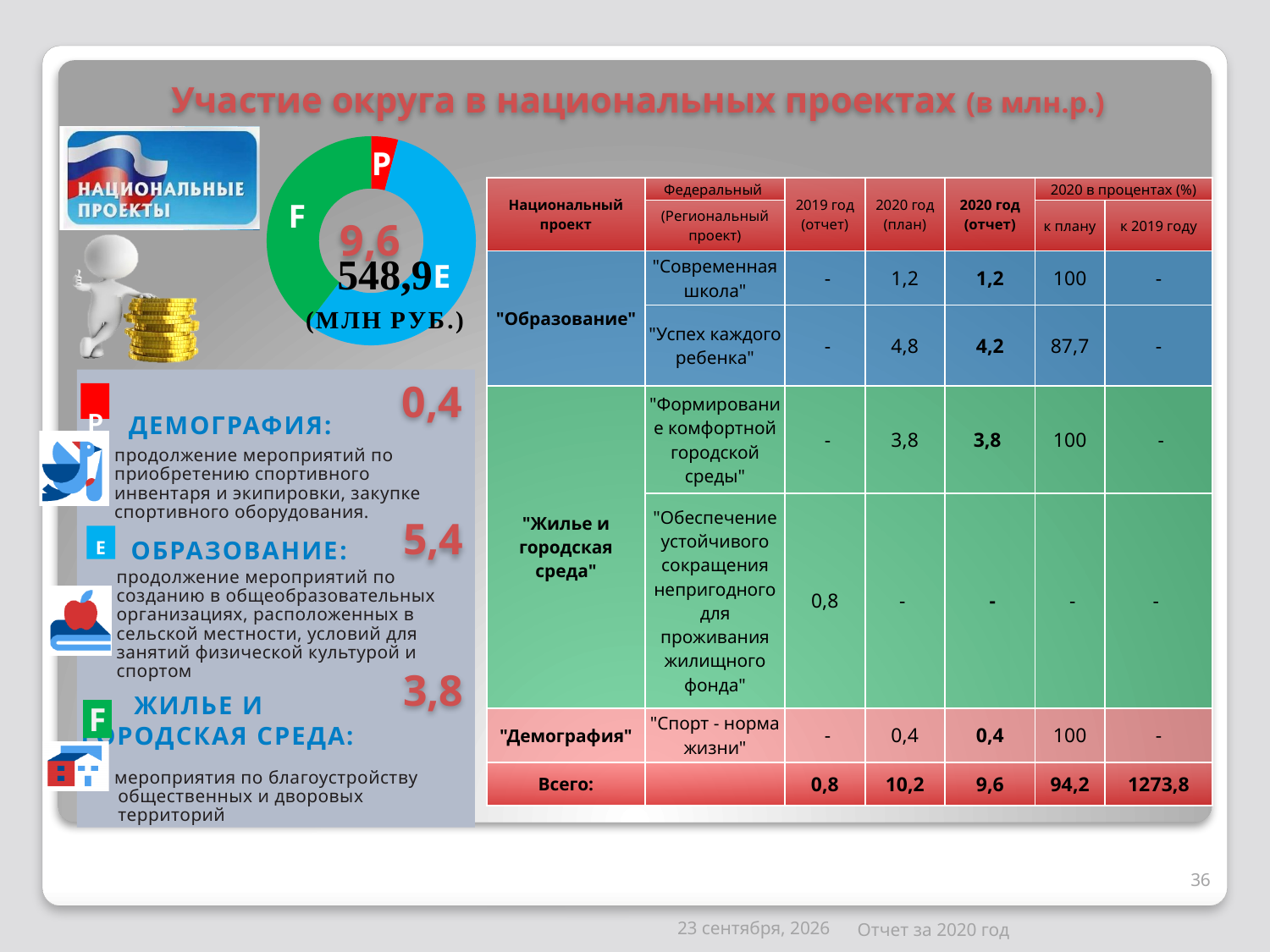
What number is printed in the centre of the doughnut chart? 9,6 What colour is the slice labelled F in the doughnut chart? green In the doughnut chart, which slice is larger, E or F? E Which slice of the doughnut chart is the smallest? P (red) How many slices does the doughnut chart have? 3 What kind of chart is shown on the slide? pie chart (doughnut) Which slice of the doughnut chart is the largest? E (blue) In the doughnut chart, which slice is larger, F or P? F